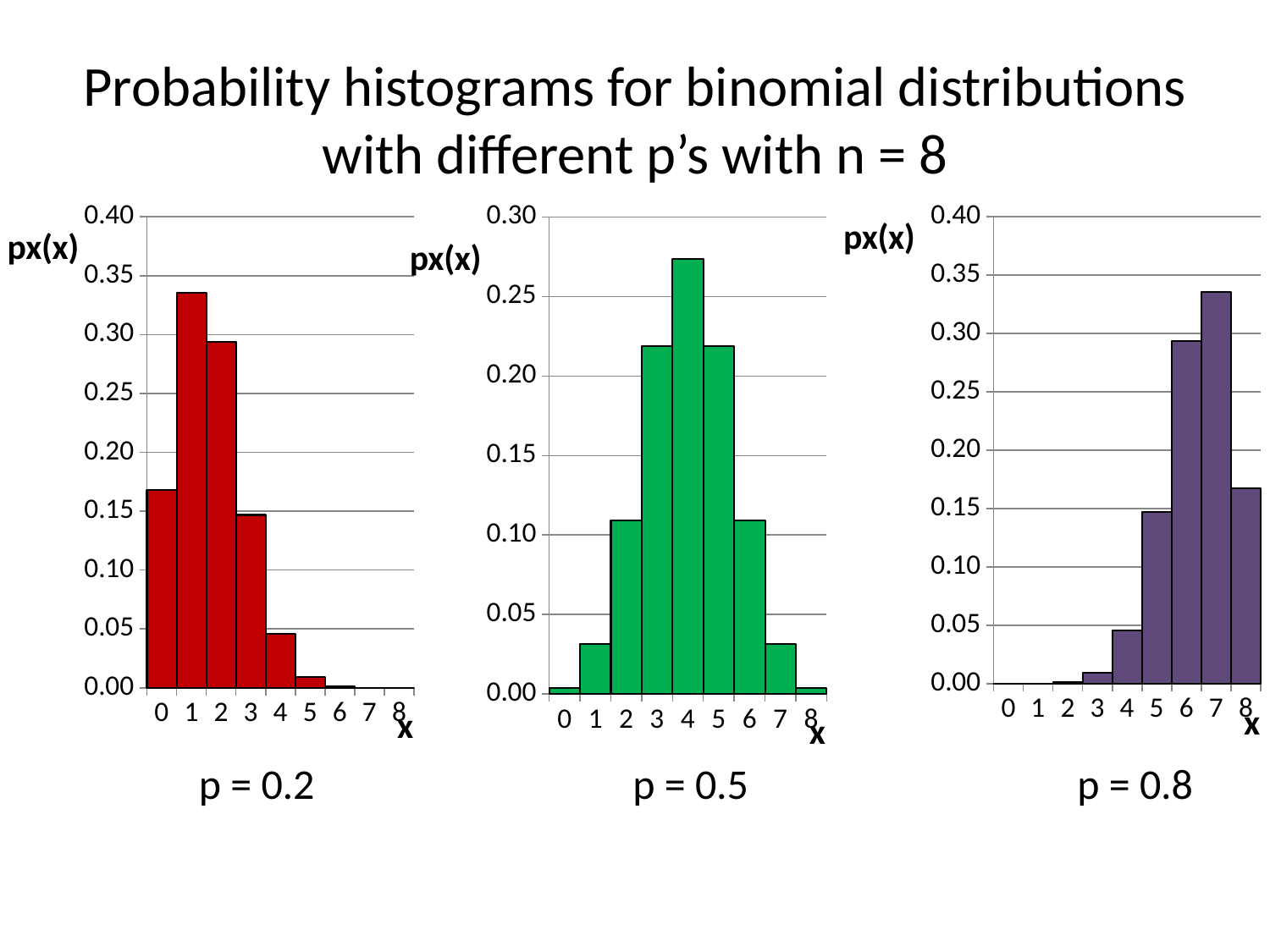
In the p = 0.5 chart, which value of x has the tallest bar? 4 In the p = 0.5 chart, which is larger, the value for x = 3 or the value for x = 4? x = 4 In the p = 0.8 chart, which is larger, the value for x = 6 or the value for x = 7? x = 7 In the p = 0.2 chart, which value of x has the tallest bar? 1 In the p = 0.8 chart, which value of x has the tallest bar? 7 In the p = 0.8 chart, do the values rise or fall from x = 0 to x = 7? rise In the p = 0.2 chart, is the value for x = 1 greater or less than 0.30? greater In the p = 0.2 chart, is the value for x = 5 greater or less than 0.05? less In the p = 0.5 chart, is the value for x = 4 greater or less than 0.25? greater How many x categories are shown on the x axis of the p = 0.5 chart? 9 What kind of chart is the p = 0.8 chart? bar chart